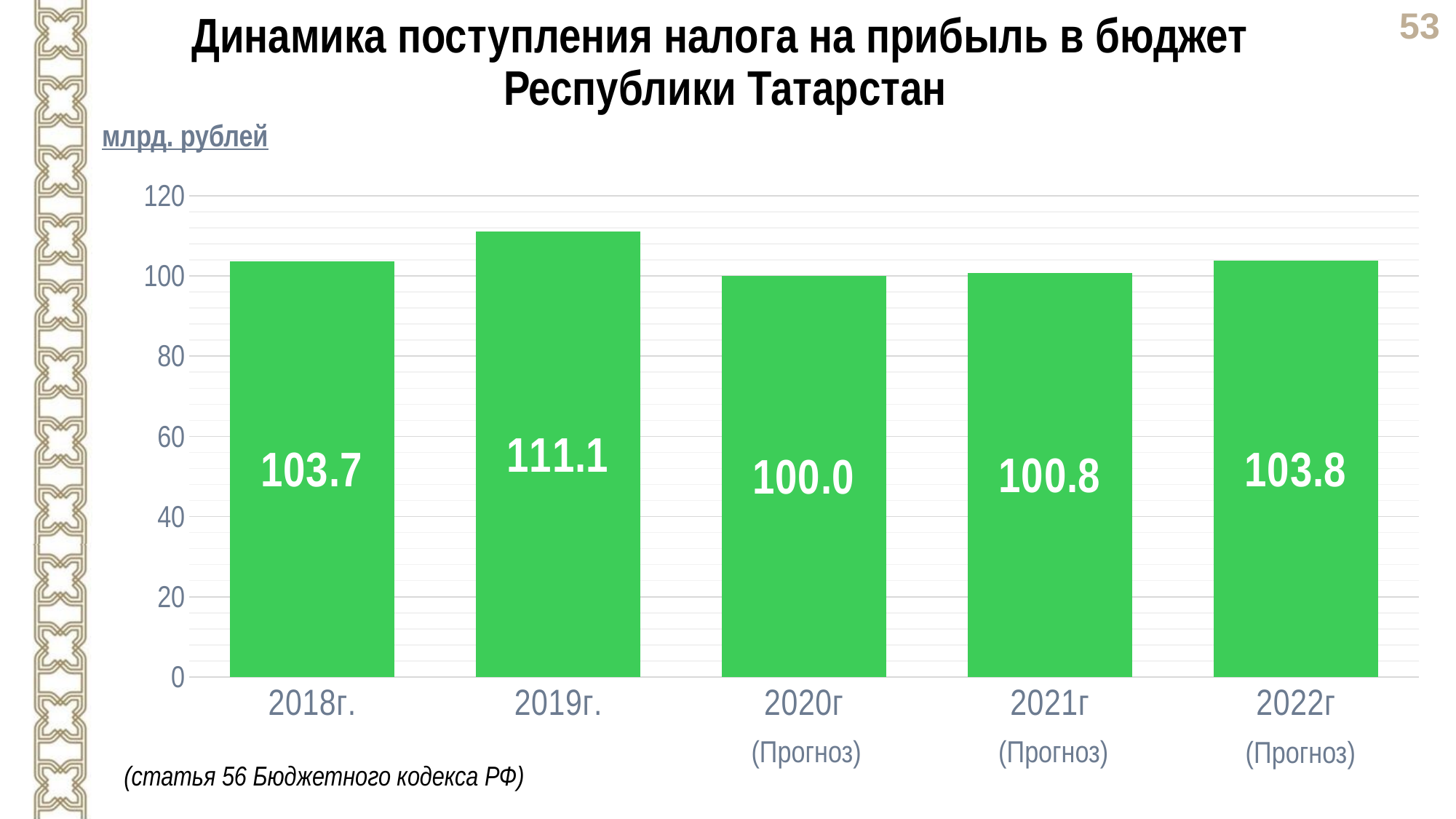
What unit is stated above the chart? млрд. рублей How many years are shown on the chart? 5 What kind of chart is shown on the slide? bar chart What is the difference between the values for 2019г. and 2018г.? 7.4 What is the value for 2019г.? 111.1 What is the value for 2022г (Прогноз)? 103.8 Which is larger, the value for 2019г. or the value for 2021г? 2019г. Which year has the lowest value? 2020г What is the value for 2020г (Прогноз)? 100.0 Is the value for 2019г. greater or less than 100? greater Which year has the highest value? 2019г. What is the difference between the values for 2021г and 2020г? 0.8